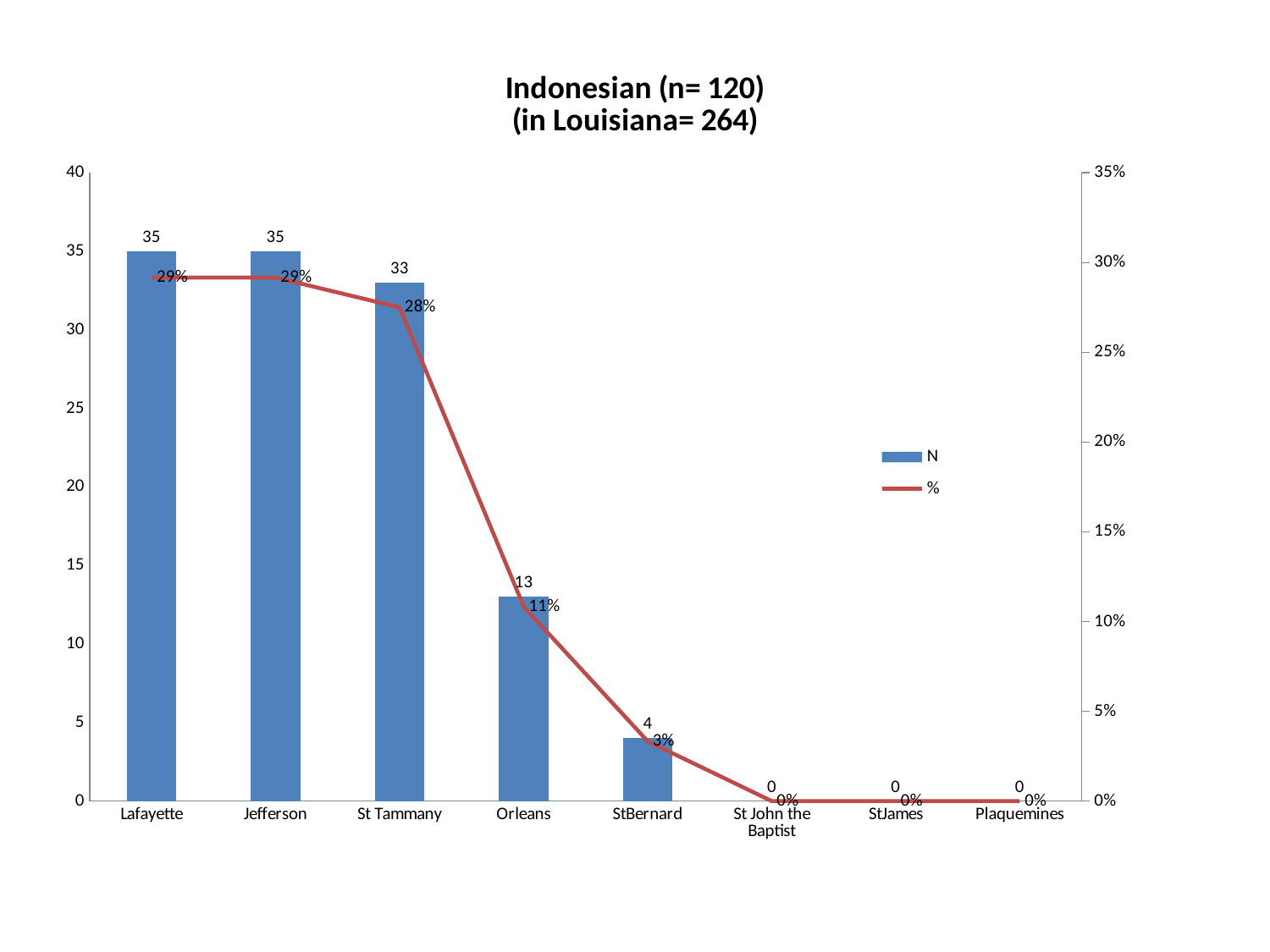
What is the % value for Orleans? 11% Is the N value for Orleans greater or less than 15? less How many series does the legend list? 2 Which category has the lowest non-zero N value? StBernard What is the N value for St Tammany? 33 What kind of chart is this? Combined bar and line chart What is the % value for St Tammany? 28% What is the difference in N between St Tammany and Orleans? 20 What is the N value for StBernard? 4 Which has a larger N value, Orleans or StBernard? Orleans How many categories are shown on the x axis? 8 Do the N values rise or fall from Lafayette to Plaquemines? fall